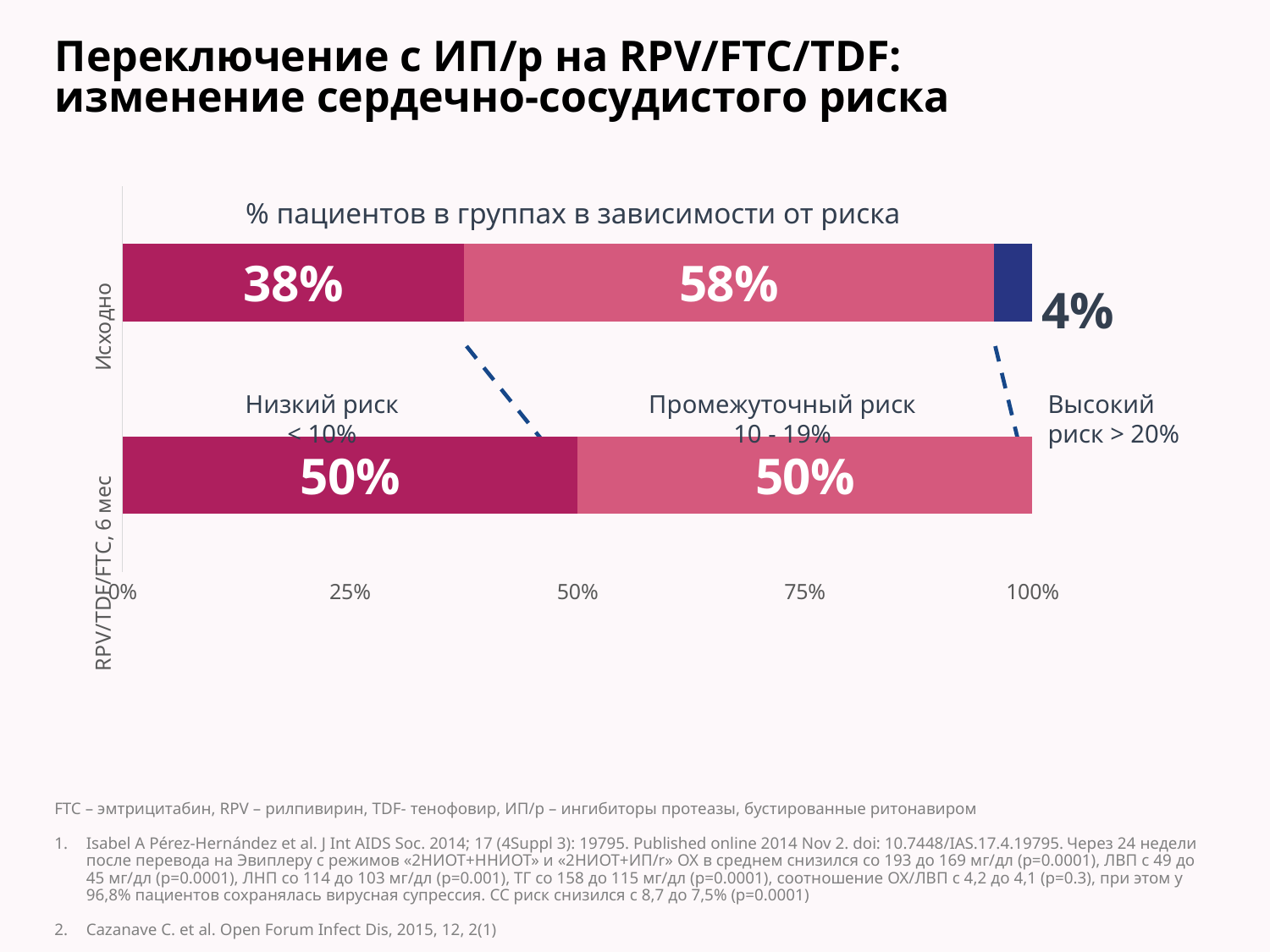
What percentage of patients were in the high-risk group (Высокий риск > 20%) at baseline (Исходно)? 4% What kind of chart is shown on the slide? stacked bar chart Which risk group had the smallest share of patients at baseline (Исходно)? Высокий риск > 20% What percentage of patients were in the low-risk group after 6 months on RPV/TDF/FTC? 50% What percentage of patients were in the intermediate-risk group (Промежуточный риск 10 - 19%) at baseline (Исходно)? 58% What is the title shown above the bars in the chart? % пациентов в группах в зависимости от риска How many bars (time points) are shown in the chart? 2 By how many percentage points did the low-risk group share increase from baseline to 6 months on RPV/TDF/FTC? 12 What percentage of patients were in the intermediate-risk group after 6 months on RPV/TDF/FTC? 50% Which risk group had the largest share of patients at baseline (Исходно)? Промежуточный риск 10 - 19% What percentage of patients were in the low-risk group (Низкий риск < 10%) at baseline (Исходно)? 38% What is the difference between the intermediate-risk and low-risk shares at baseline (Исходно)? 20